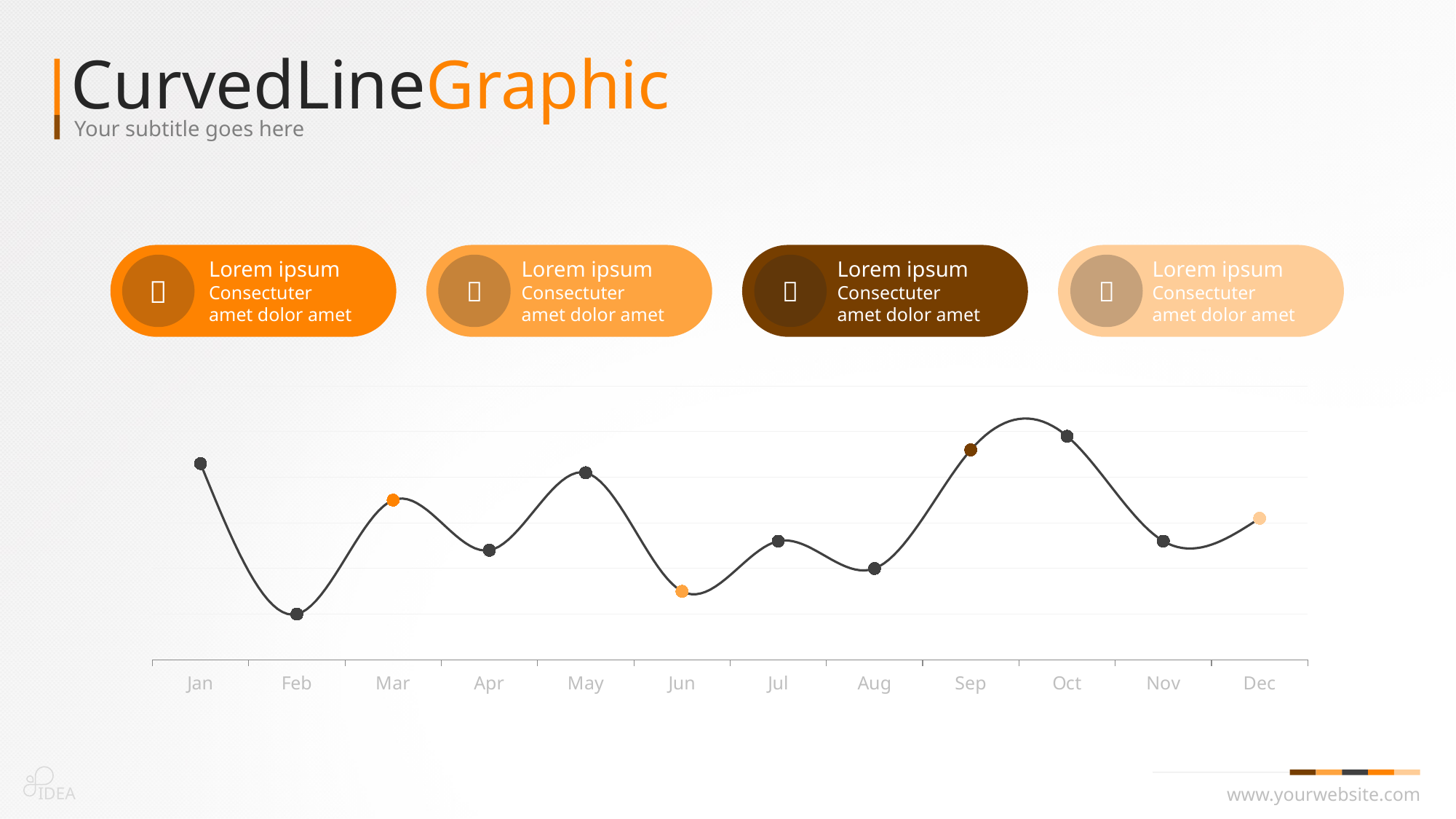
What is the first month label on the x axis of the chart? Jan Does the line rise or fall from Aug to Sep? rise How many months are plotted along the x axis of the chart? 12 Which is higher on the line, Mar or Apr? Mar Does the line rise or fall from Jan to Feb? fall Which is higher on the line, Oct or Nov? Oct Which is higher on the line, May or Jun? May Which month has the lowest point on the line? Feb What kind of chart is shown on the slide? line chart What is the title of the slide containing the chart? Curved Line Graphic